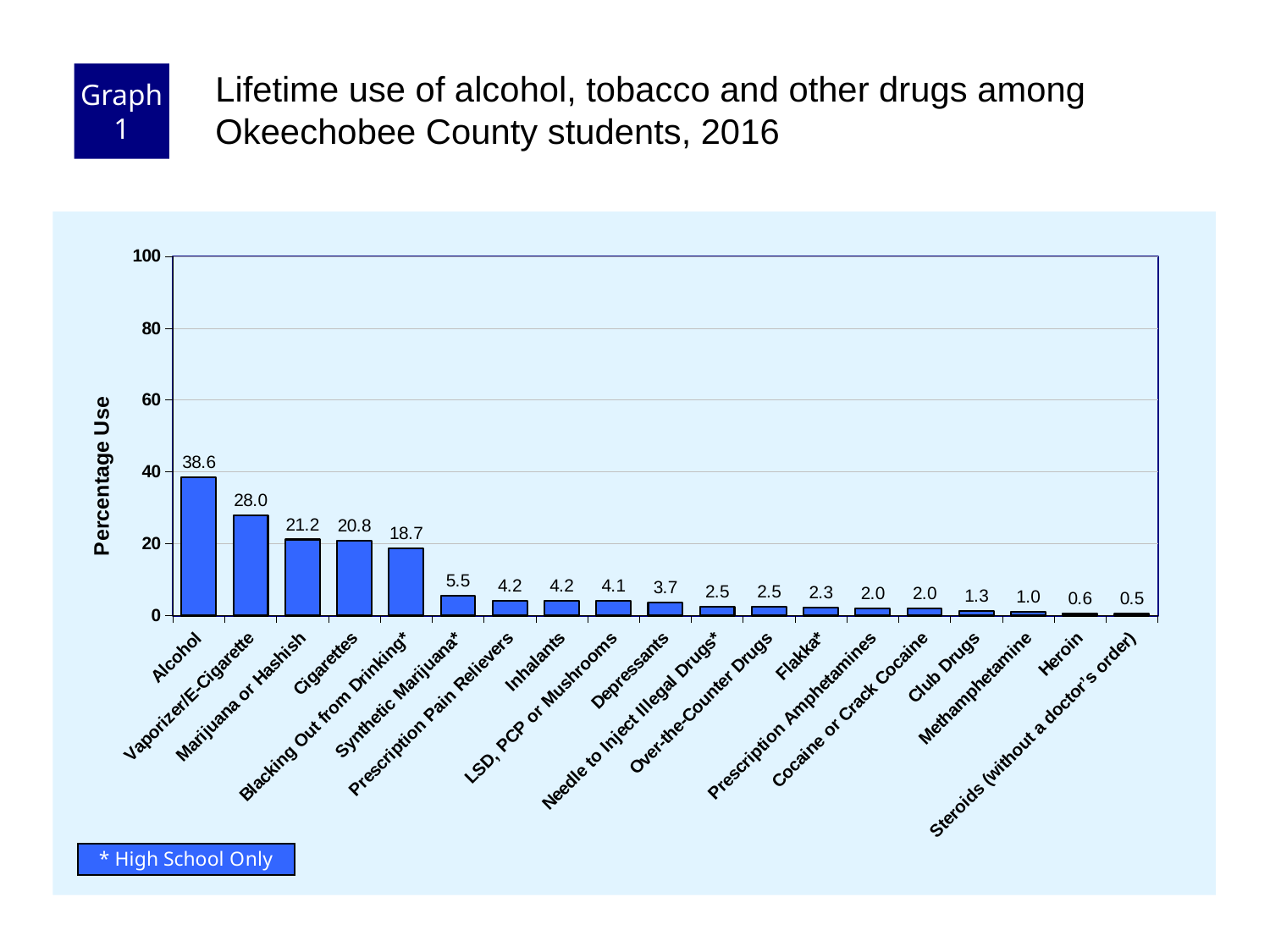
What is the label of the y axis? Percentage Use Which has a higher percentage use, Marijuana or Hashish or Cigarettes? Marijuana or Hashish What is the percentage use for Heroin? 0.6 What is the percentage use for Synthetic Marijuana*? 5.5 What is the difference in percentage use between Alcohol and Vaporizer/E-Cigarette? 10.6 How many categories are shown on the chart? 19 Which category has the highest percentage use? Alcohol Is the value for Blacking Out from Drinking* greater or less than 20? less What is the percentage use for Vaporizer/E-Cigarette? 28.0 What is the percentage use for Alcohol? 38.6 Which category has the lowest percentage use? Steroids (without a doctor's order) What kind of chart is shown on the slide? Bar chart